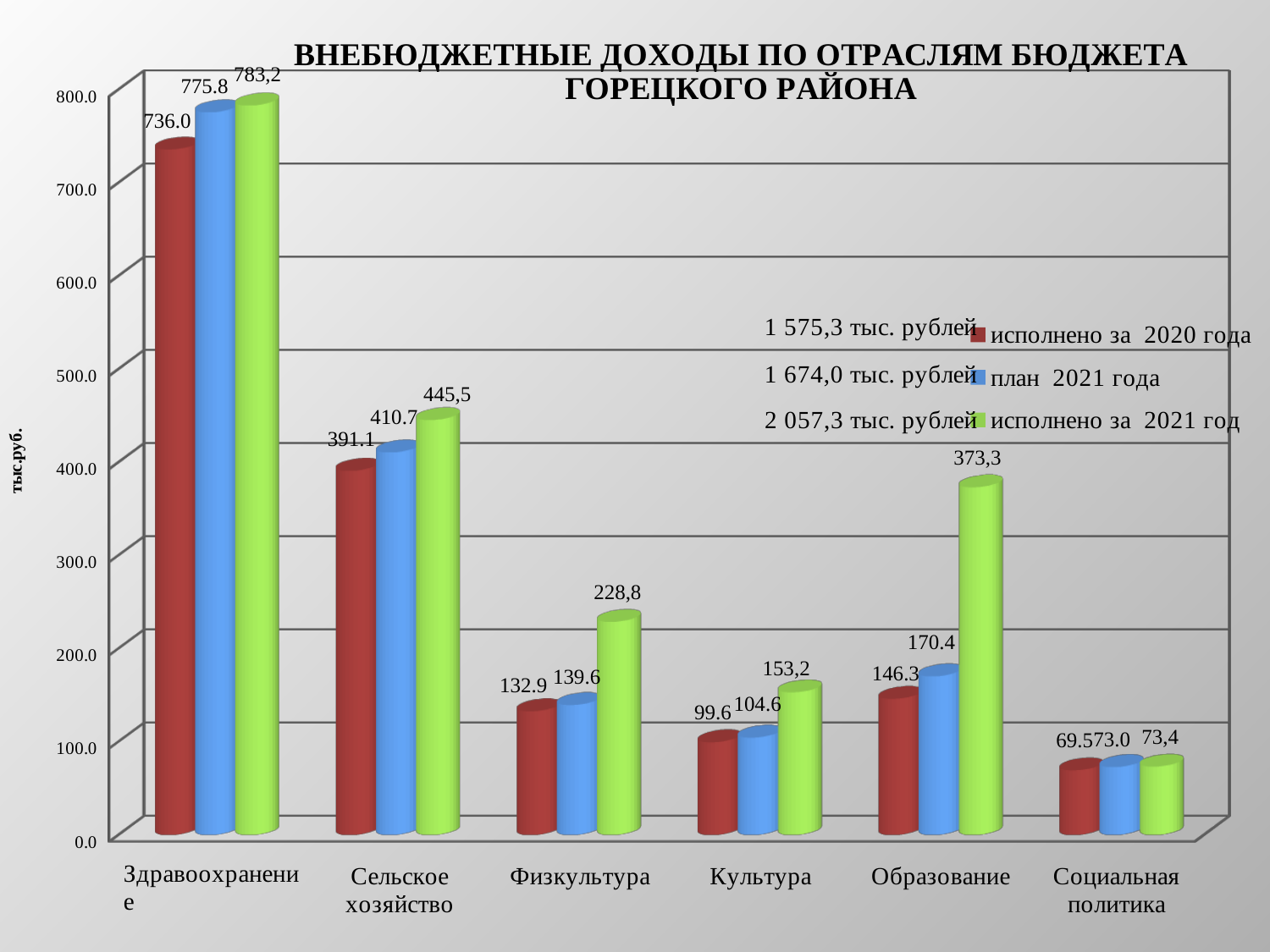
How many series does the legend list? 3 What is the value for Здравоохранение in the series 'исполнено за 2020 года'? 736.0 What is the value for Образование in the series 'исполнено за 2021 год'? 373,3 In the series 'исполнено за 2021 год', which is larger: Физкультура or Культура? Физкультура Which category has the lowest value in the series 'исполнено за 2020 года'? Социальная политика How many categories are shown on the x axis? 6 What colour represents the series 'план 2021 года'? blue Is the value for Культура in the series 'исполнено за 2020 года' greater or less than 100.0? less For Здравоохранение, what is the difference between 'план 2021 года' and 'исполнено за 2020 года'? 39.8 What is the value for Сельское хозяйство in the series 'план 2021 года'? 410.7 What kind of chart is shown on the slide? bar chart Which category has the highest value in the series 'план 2021 года'? Здравоохранение